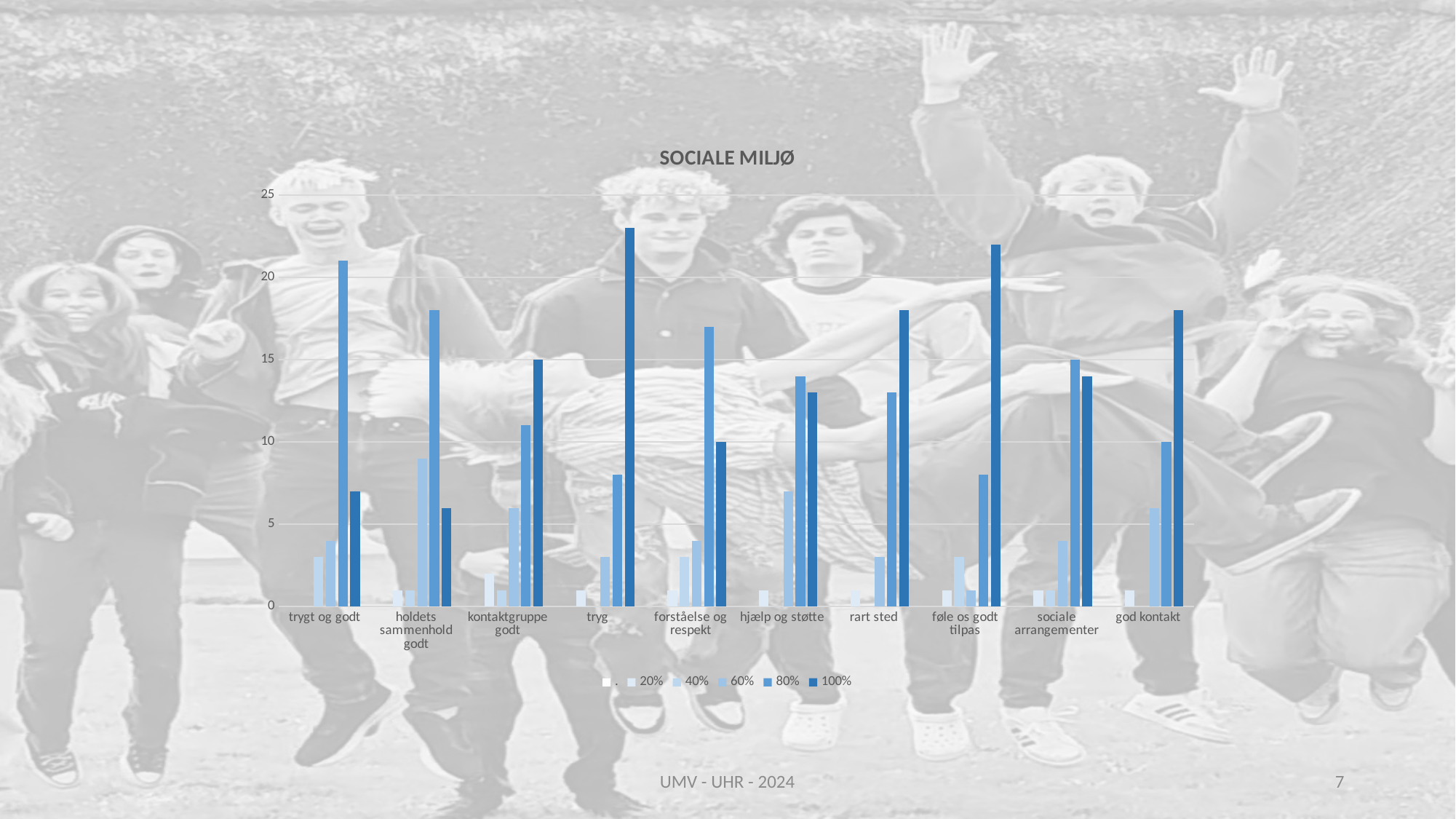
Which category has the highest 80% bar? trygt og godt What is the title of the chart? SOCIALE MILJØ Is the 100% value for 'trygt og godt' greater or less than 10? less How many categories are shown along the x axis of the chart? 10 For 'tryg', which is larger: the 80% bar or the 100% bar? 100% Is the 80% value for 'trygt og godt' greater or less than 20? greater How many series does the chart's legend list? 6 Is the 100% value for 'føle os godt tilpas' greater or less than 20? greater What type of chart is shown on the slide? bar chart For 'trygt og godt', which is larger: the 80% bar or the 100% bar? 80%